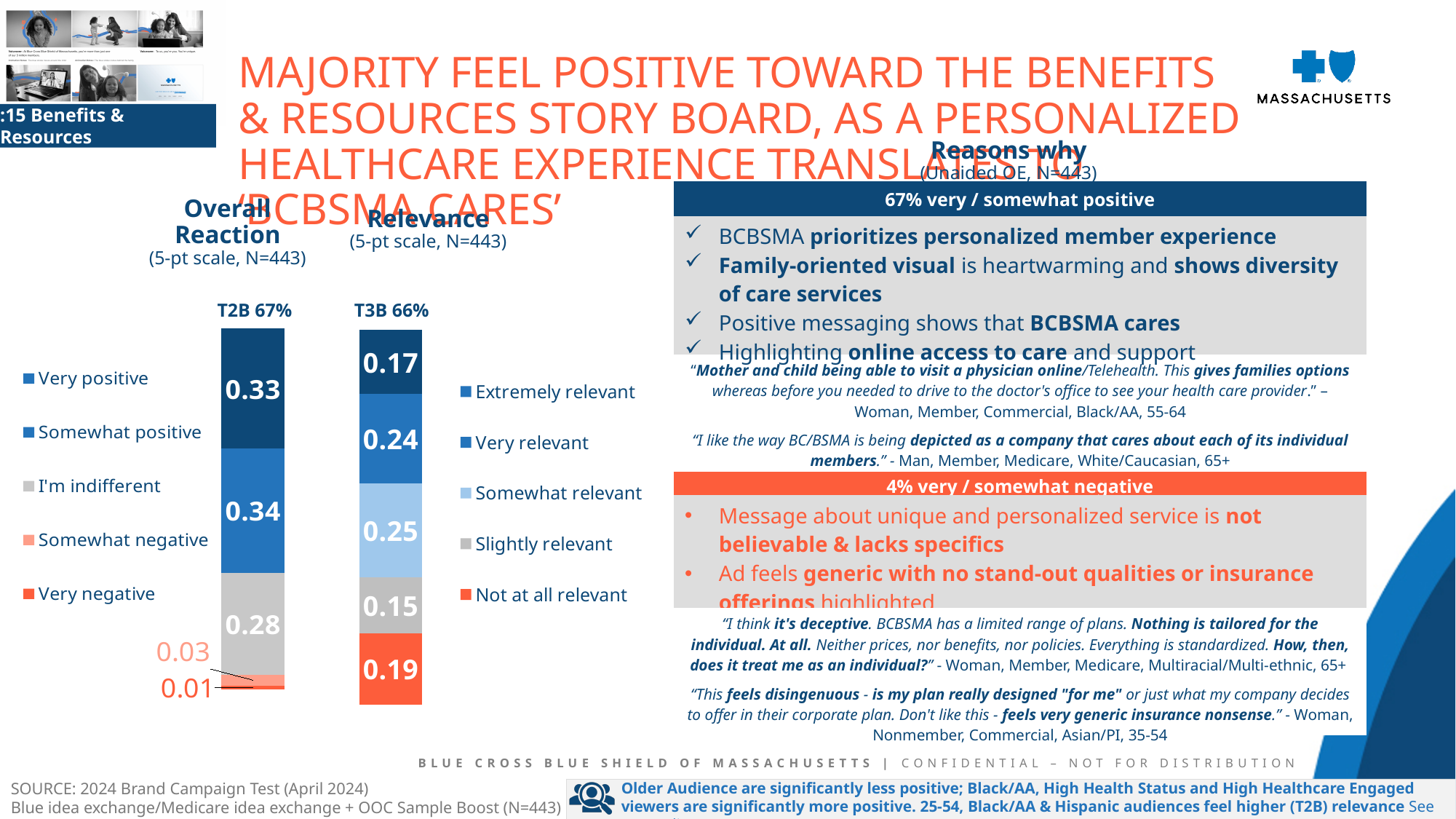
In the Relevance chart, which category has the lowest value? Slightly relevant In the Overall Reaction chart, which category has the lowest value? Very negative In the Relevance chart, what is the value for Somewhat relevant? 0.25 In the Overall Reaction chart, what is the value for Very positive? 0.33 In the Overall Reaction chart, what is the value for Somewhat positive? 0.34 In the Overall Reaction chart, which is larger: I'm indifferent or Somewhat negative? I'm indifferent How many series does the legend of the Relevance chart list? 5 In the Relevance chart, what is the difference between Very relevant and Extremely relevant? 0.07 In the Relevance chart, what is the value for Not at all relevant? 0.19 What type of chart is the Overall Reaction chart? Stacked bar chart In the Overall Reaction chart, what is the value for Very negative? 0.01 In the Overall Reaction chart, what is the value for I'm indifferent? 0.28